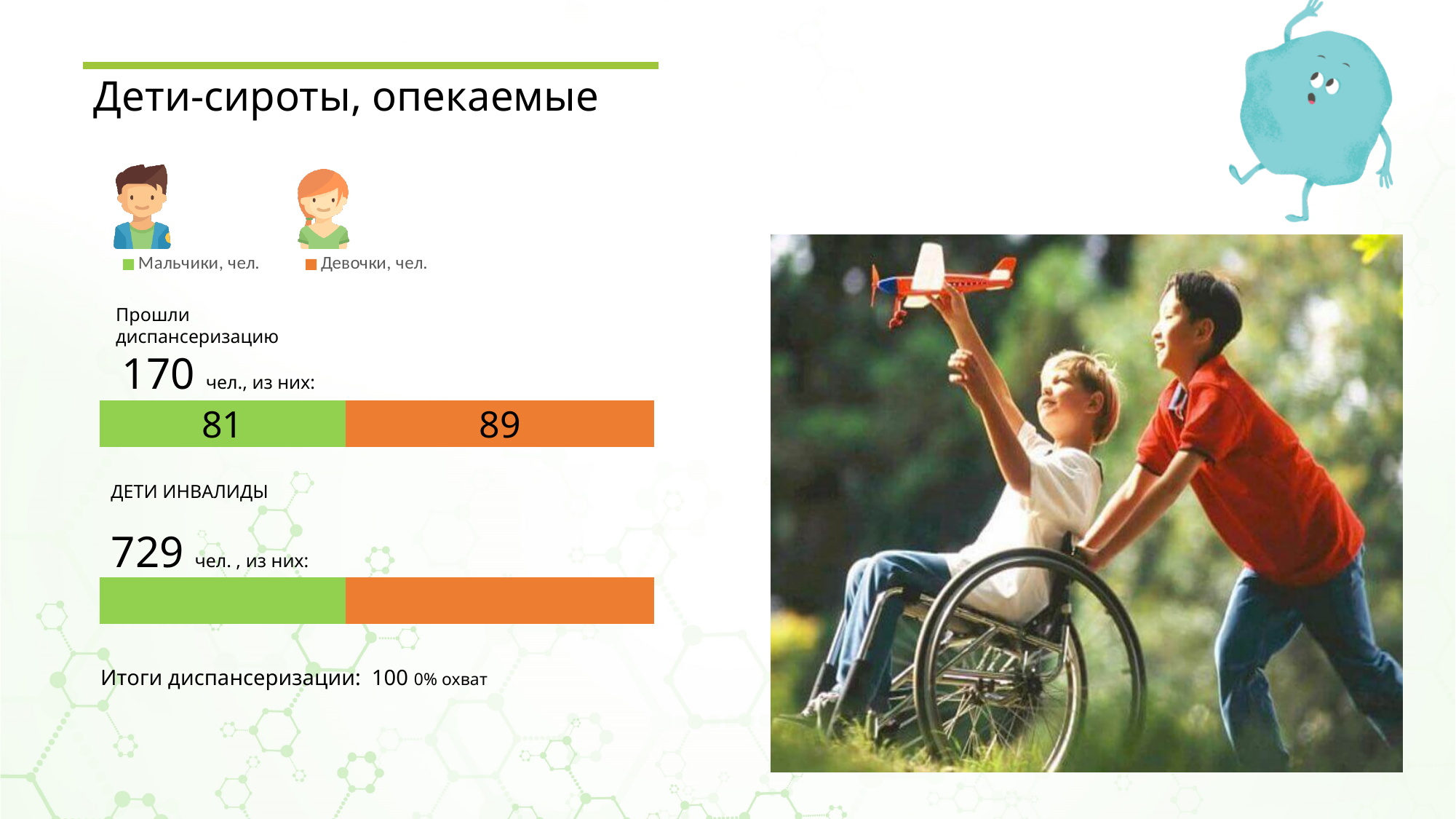
In the 'Прошли диспансеризацию' chart, what is the value for Мальчики, чел.? 81 In the 'Прошли диспансеризацию' chart, which is larger: Мальчики or Девочки? Девочки In the 'Прошли диспансеризацию' chart, what is the difference between the Девочки and Мальчики values? 8 How many series does the legend list for the charts on the slide? 2 In the 'Прошли диспансеризацию' chart, what is the value for Девочки, чел.? 89 In the 'Прошли диспансеризацию' chart, which category has the lowest value? Мальчики What colour represents Девочки, чел. in the legend? Orange What colour represents Мальчики, чел. in the legend? Green In the 'Прошли диспансеризацию' chart, what is the total of the stacked bar? 170 What kind of chart is used for 'Прошли диспансеризацию'? Stacked bar chart In the 'ДЕТИ ИНВАЛИДЫ' chart, which segment is larger: Мальчики or Девочки? Девочки In the 'Прошли диспансеризацию' chart, which category has the highest value? Девочки